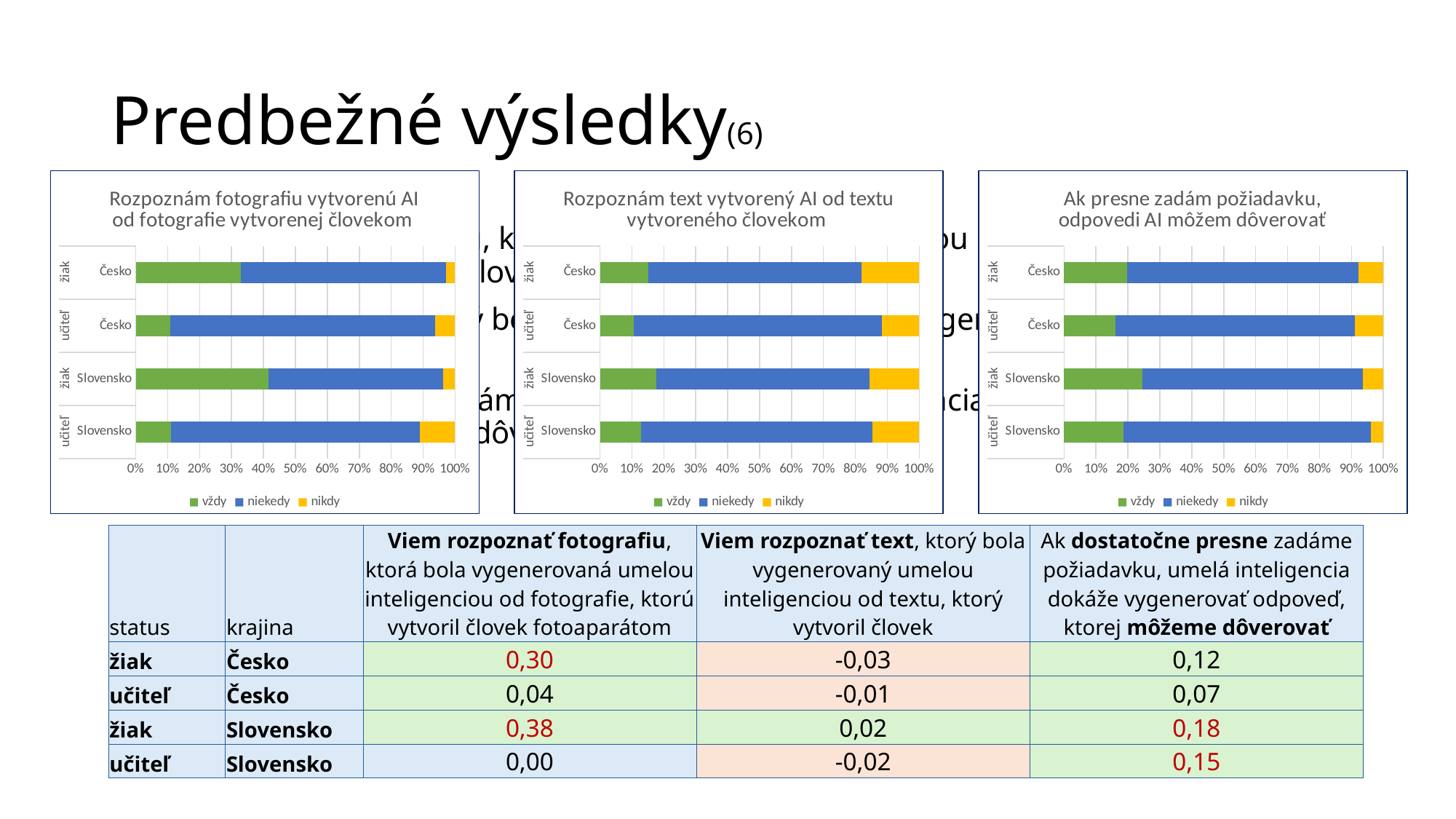
How many category bars are plotted in the right chart 'Ak presne zadám požiadavku, odpovedi AI môžem dôverovať'? 4 In the right chart 'Ak presne zadám požiadavku, odpovedi AI môžem dôverovať', what is the total of the stacked bar for žiak Česko? 100% In the left chart 'Rozpoznám fotografiu vytvorenú AI od fotografie vytvorenej človekom', which category has the largest 'vždy' segment? žiak Slovensko In the middle chart 'Rozpoznám text vytvorený AI od textu vytvoreného človekom', is the 'vždy' share for žiak Slovensko greater or less than 20%? less In the middle chart 'Rozpoznám text vytvorený AI od textu vytvoreného človekom', which has the larger 'vždy' segment: žiak Slovensko or učiteľ Česko? žiak Slovensko In the left chart 'Rozpoznám fotografiu vytvorenú AI od fotografie vytvorenej človekom', is the 'vždy' share for žiak Česko greater or less than 40%? less How many series does the legend of the middle chart 'Rozpoznám text vytvorený AI od textu vytvoreného človekom' list? 3 In the right chart 'Ak presne zadám požiadavku, odpovedi AI môžem dôverovať', is the 'nikdy' share for učiteľ Slovensko greater or less than 10%? less What kind of chart is the left chart titled 'Rozpoznám fotografiu vytvorenú AI od fotografie vytvorenej človekom'? stacked bar chart Which colour represents the 'nikdy' series in the three charts? yellow